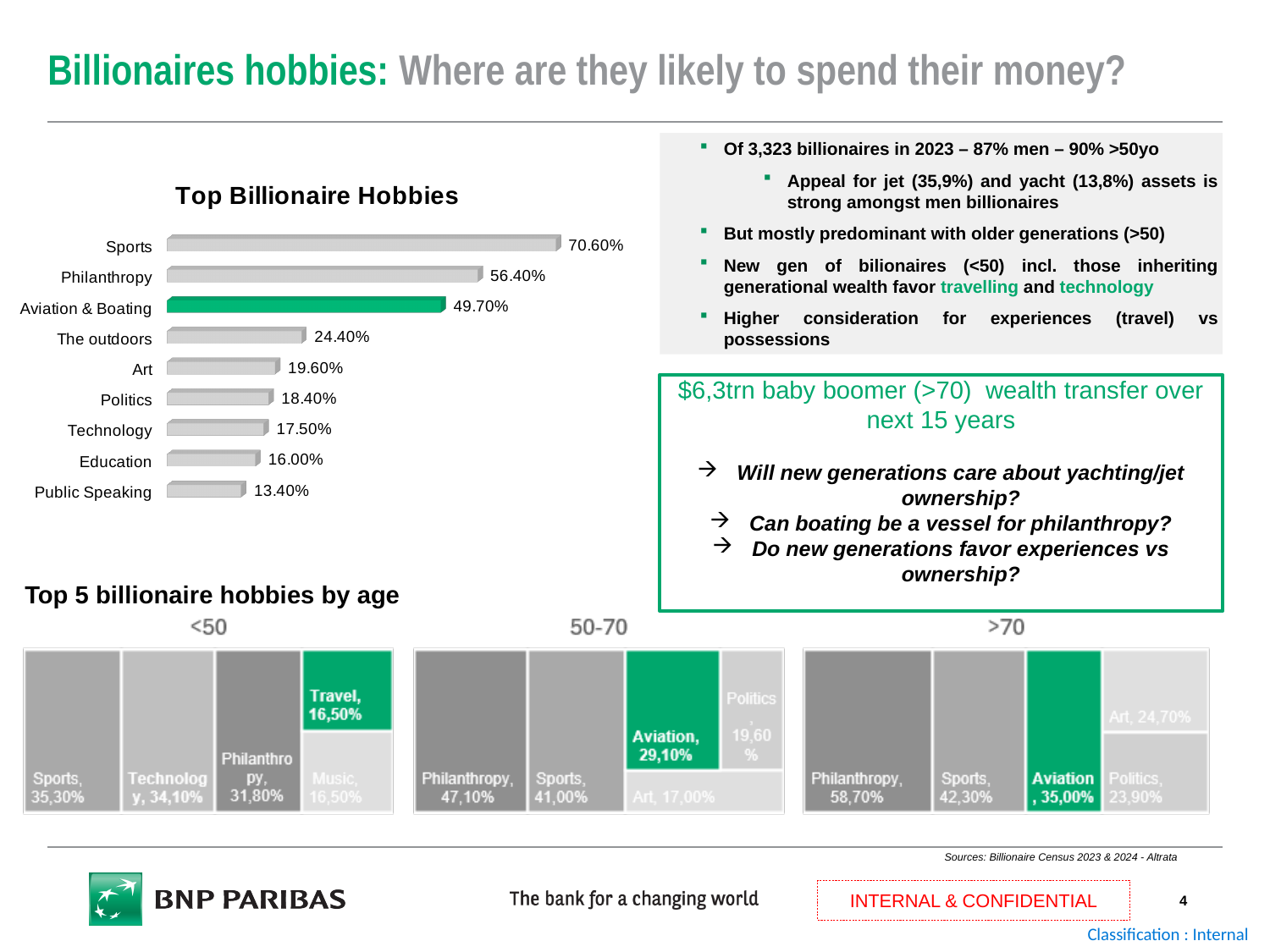
How many hobby categories are shown in the 'Top Billionaire Hobbies' chart? 9 In the 'Top 5 billionaire hobbies by age' charts, what is the value for Philanthropy in the >70 group? 58,70% In the 'Top Billionaire Hobbies' chart, what is the value for Aviation & Boating? 49.70% In the 'Top Billionaire Hobbies' chart, which is larger, Art or Education? Art What type of chart is 'Top Billionaire Hobbies'? Bar chart In the 'Top Billionaire Hobbies' chart, what is the difference between Sports and Philanthropy? 14.20% In the 'Top 5 billionaire hobbies by age' charts, what is the value for Aviation in the 50-70 group? 29,10% In the 'Top Billionaire Hobbies' chart, which hobby has the lowest value? Public Speaking In the 'Top Billionaire Hobbies' chart, which hobby has the highest value? Sports In the 'Top Billionaire Hobbies' chart, what is the value for Sports? 70.60% In the 'Top Billionaire Hobbies' chart, which bar is coloured green rather than grey? Aviation & Boating In the 'Top Billionaire Hobbies' chart, what is the value for Technology? 17.50%